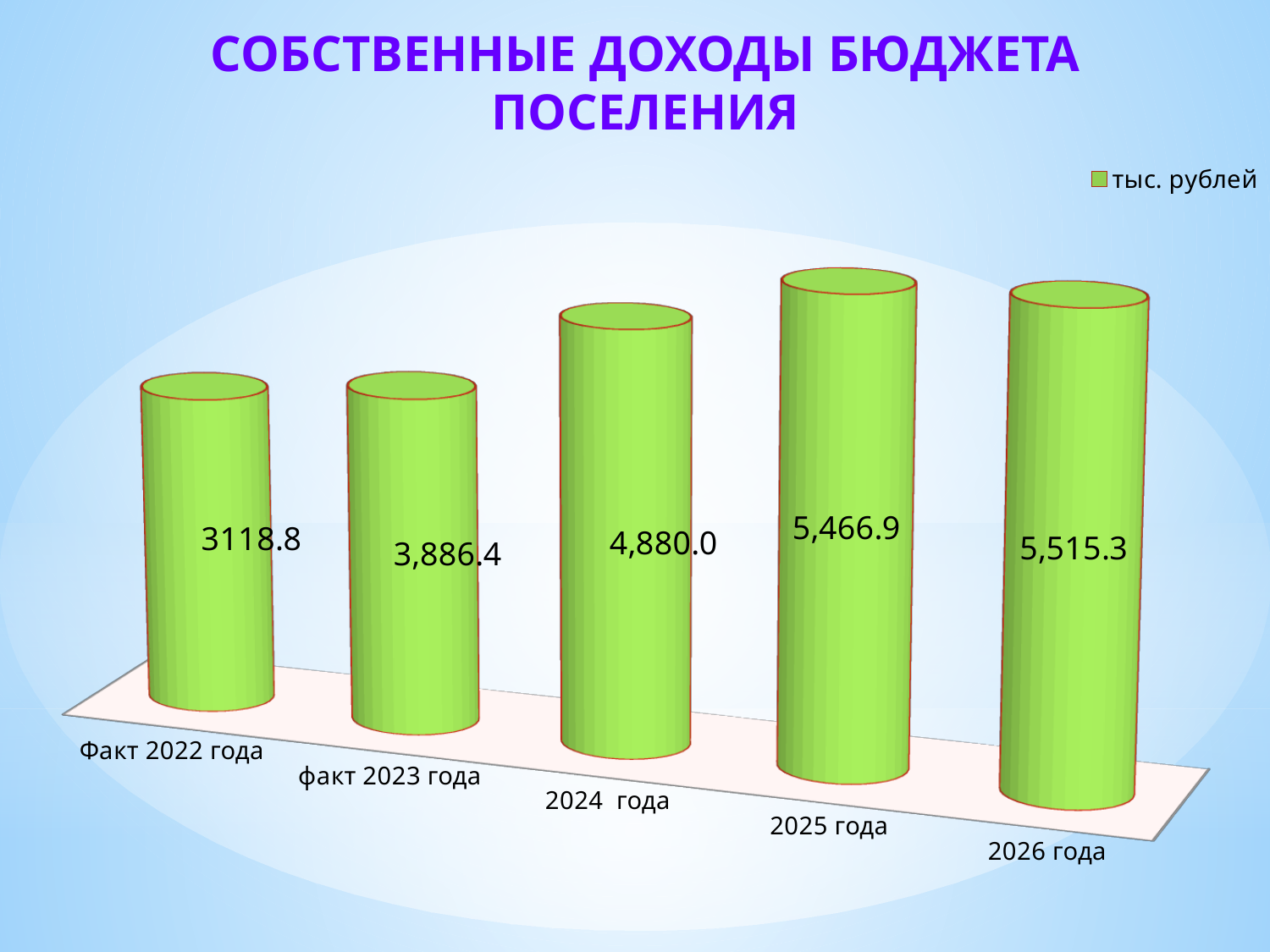
What is the value for Факт 2022 года? 3118.8 What is the difference between the values for 2026 года and 2025 года? 48.4 Which is larger, the value for 2024 года or the value for факт 2023 года? 2024 года Do the values rise or fall from Факт 2022 года to 2026 года? rise Which category has the lowest value? Факт 2022 года What is the value for 2025 года? 5,466.9 Which category has the highest value? 2026 года What is the difference between the values for 2024 года and факт 2023 года? 993.6 What is the value for 2026 года? 5,515.3 What is the value for факт 2023 года? 3,886.4 How many categories are shown on the chart? 5 What is the value for 2024 года? 4,880.0